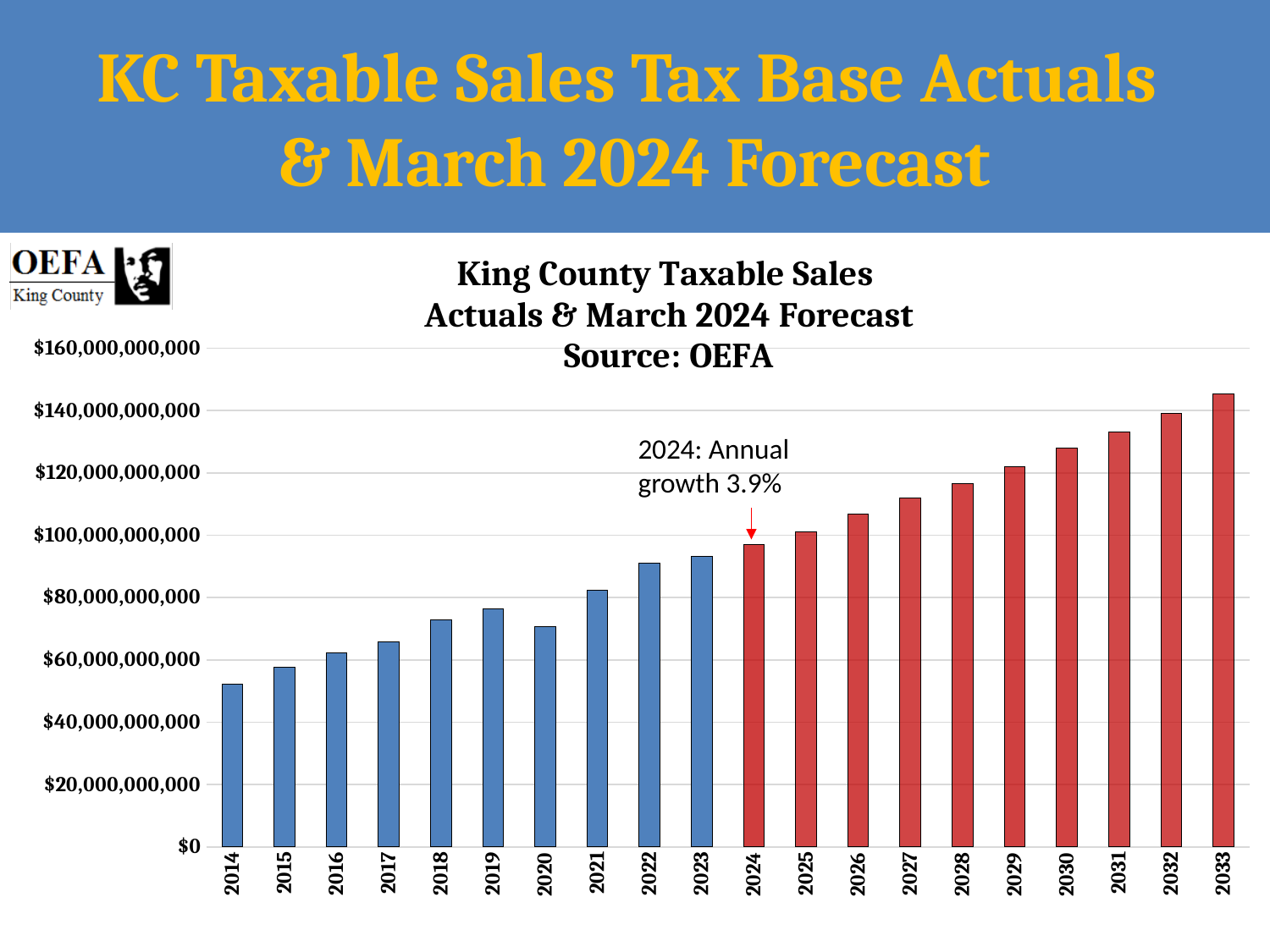
Is the value for 2014 greater or less than $60,000,000,000? less Is the value for 2033 greater or less than $140,000,000,000? greater What kind of chart is shown on the slide? Bar chart How many years are plotted on the x axis of the chart? 20 Which year has the highest taxable sales value in the chart? 2033 Which year has the larger taxable sales value, 2019 or 2020? 2019 Which year has the lowest taxable sales value in the chart? 2014 What annual growth rate does the annotation on the chart give for 2024? 3.9% Is the value for 2020 greater or less than $80,000,000,000? less Do the taxable sales values generally rise or fall from 2014 to 2033? Rise